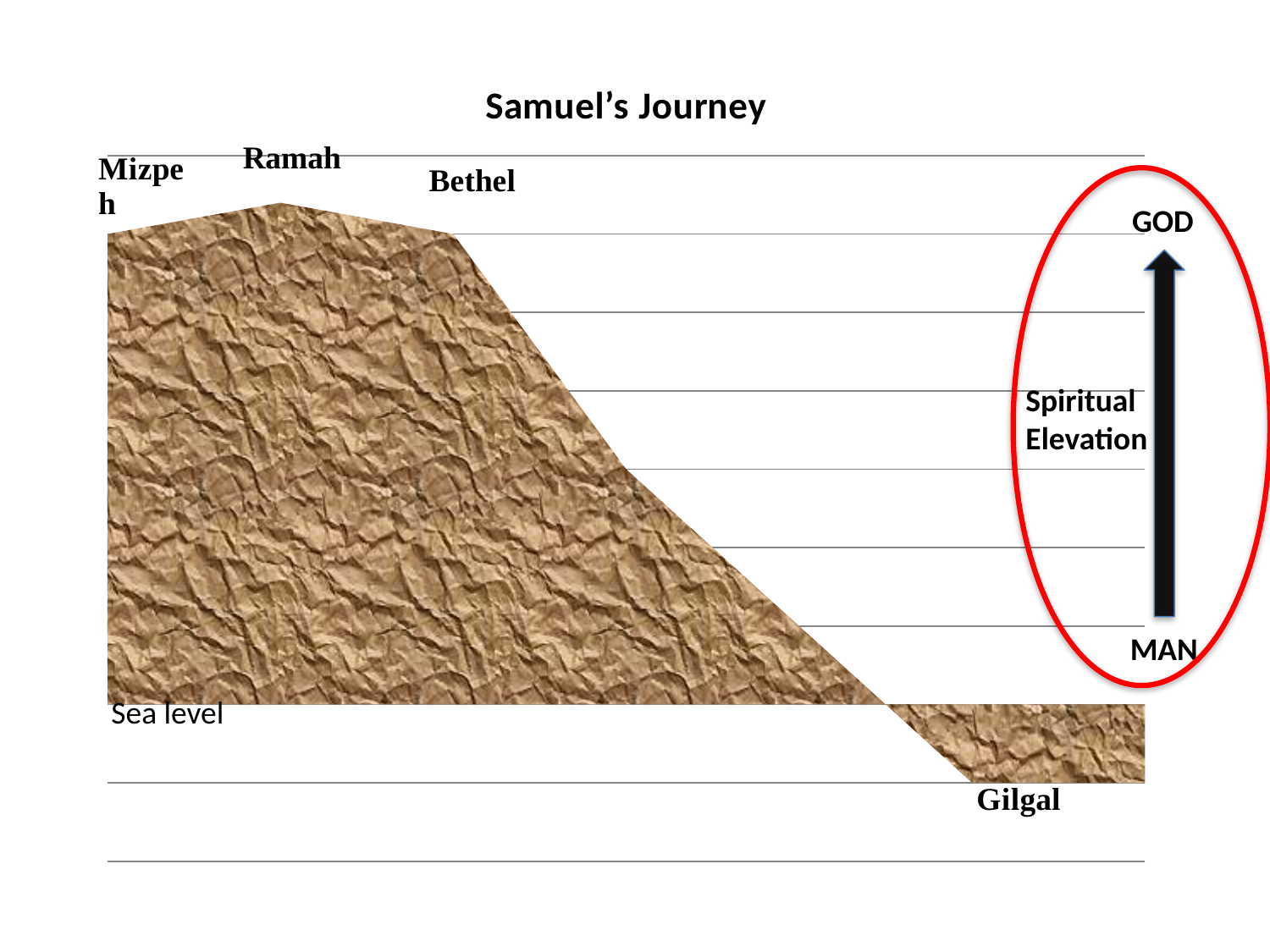
What label is written at the top of the vertical arrow inside the red oval? GOD What kind of chart is shown on the slide? Area chart Which labeled location has the lowest elevation on the chart? Gilgal What is the title of the chart? Samuel's Journey Which is at a higher elevation, Ramah or Mizpeh? Ramah How many named locations are labeled along the journey on the chart? 4 Which labeled location has the highest elevation on the chart? Ramah Is Gilgal shown above or below sea level on the chart? Below Does the elevation rise or fall moving from Bethel to Gilgal along the x axis? Fall Which is at a higher elevation, Bethel or Gilgal? Bethel